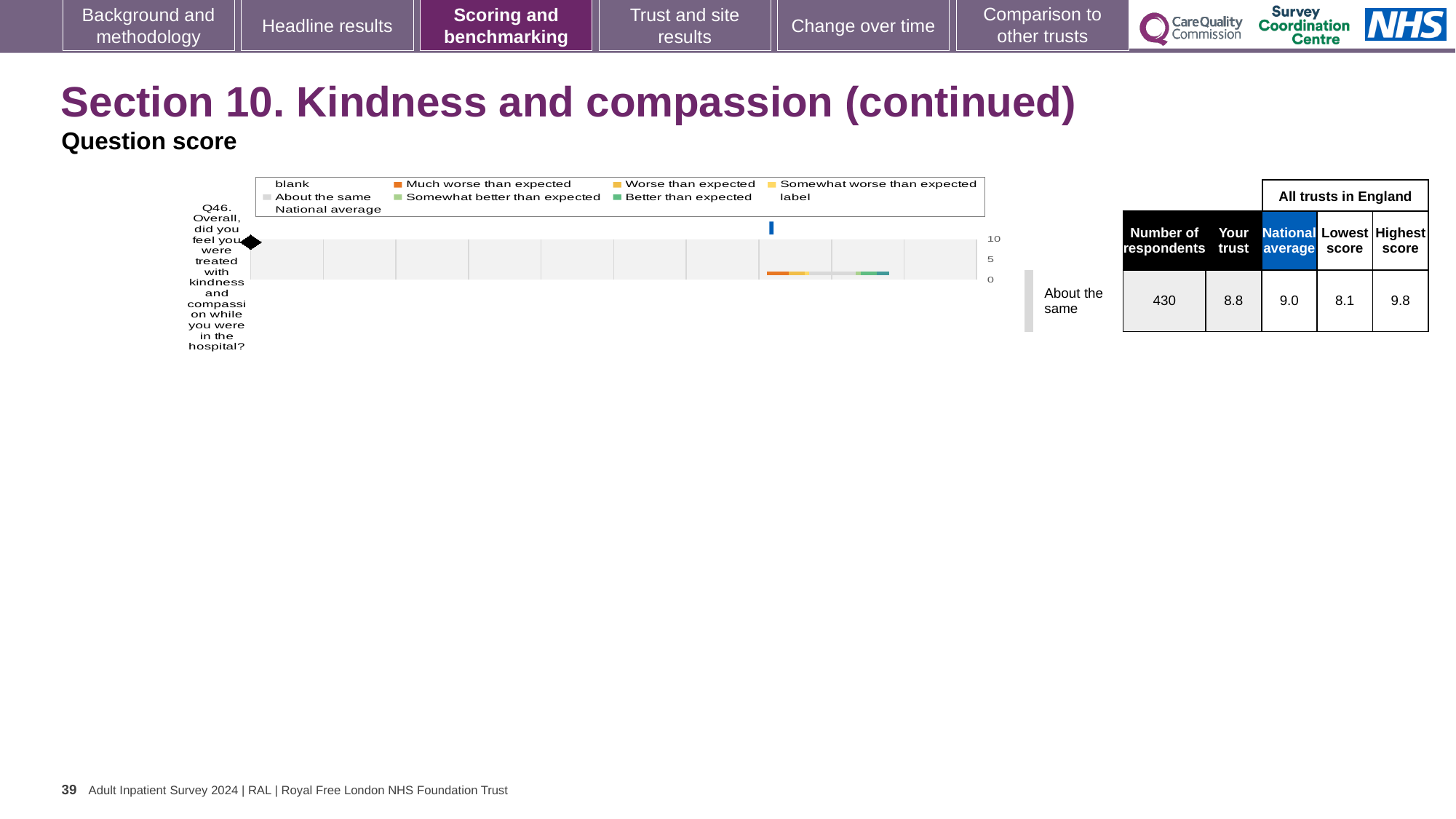
What is the national average score for Q46? 9.0 What is the number of respondents for Q46? 430 What is the highest score among all trusts in England for Q46? 9.8 What is the 'Your trust' score for Q46? 8.8 Which survey question does the chart relate to? Q46. Overall, did you feel you were treated with kindness and compassion while you were in the hospital? What is the highest tick value shown on the chart's score axis? 10 Which is larger for Q46, the 'Your trust' score or the national average? National average What type of chart is shown on the slide? bar chart What is the lowest score among all trusts in England for Q46? 8.1 How many entries does the chart's legend list? 9 Which benchmarking category is the trust's Q46 result placed in? About the same What is the difference between the highest and lowest scores among all trusts in England for Q46? 1.7